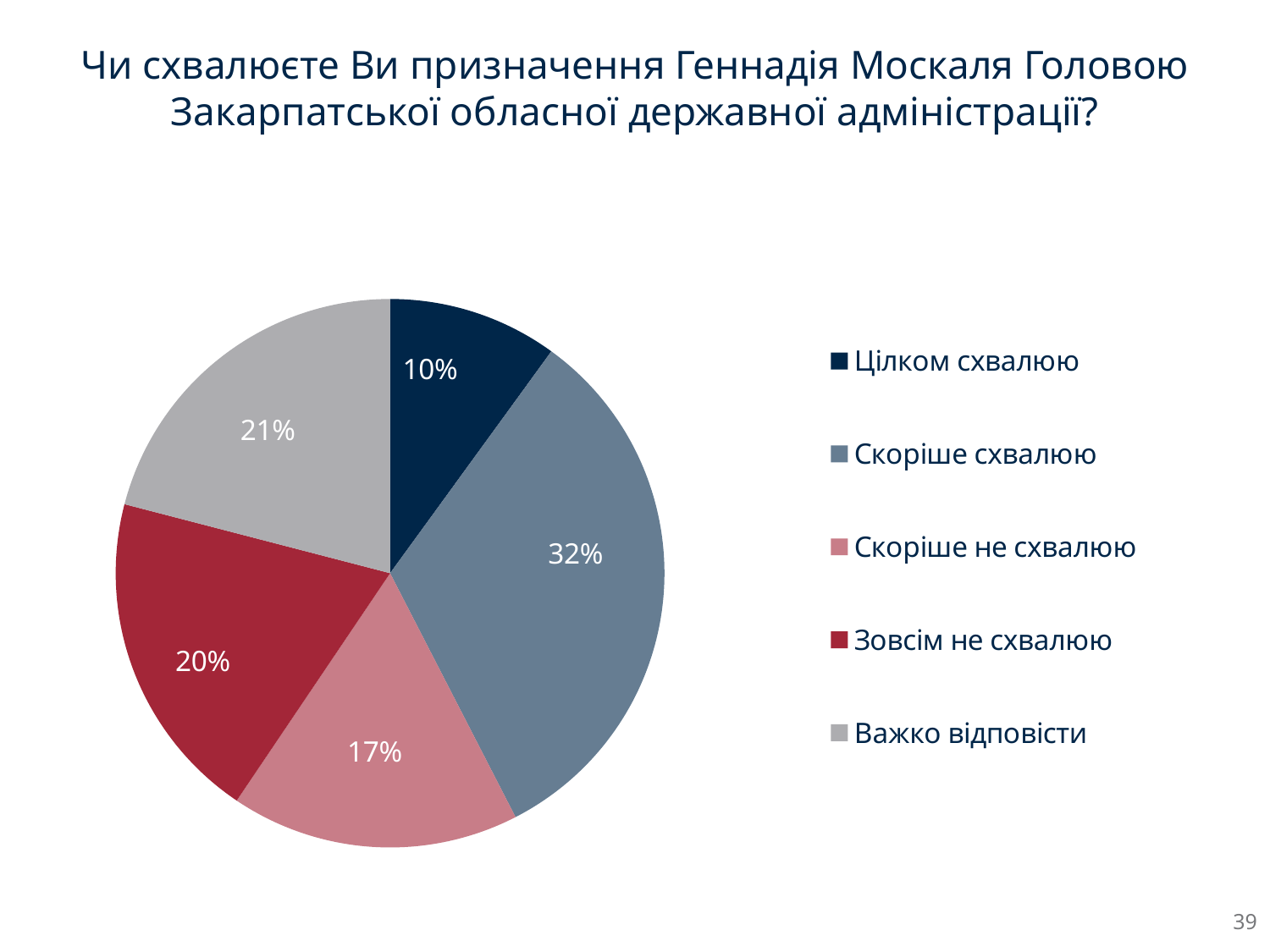
Which answer option has the smallest share of the pie? Цілком схвалюю What type of chart is shown on the slide? Pie chart Which is larger: the share for "Зовсім не схвалюю" or the share for "Цілком схвалюю"? Зовсім не схвалюю Which answer option has the largest share of the pie? Скоріше схвалюю What is the difference in percentage points between "Скоріше схвалюю" and "Скоріше не схвалюю"? 15 What share of respondents answered "Цілком схвалюю"? 10% What share of respondents answered "Скоріше не схвалюю"? 17% What colour is the slice for "Важко відповісти"? Grey What share of respondents answered "Важко відповісти"? 21% How many answer categories are shown in the pie chart? 5 What share of respondents answered "Зовсім не схвалюю"? 20% What share of respondents answered "Скоріше схвалюю"? 32%